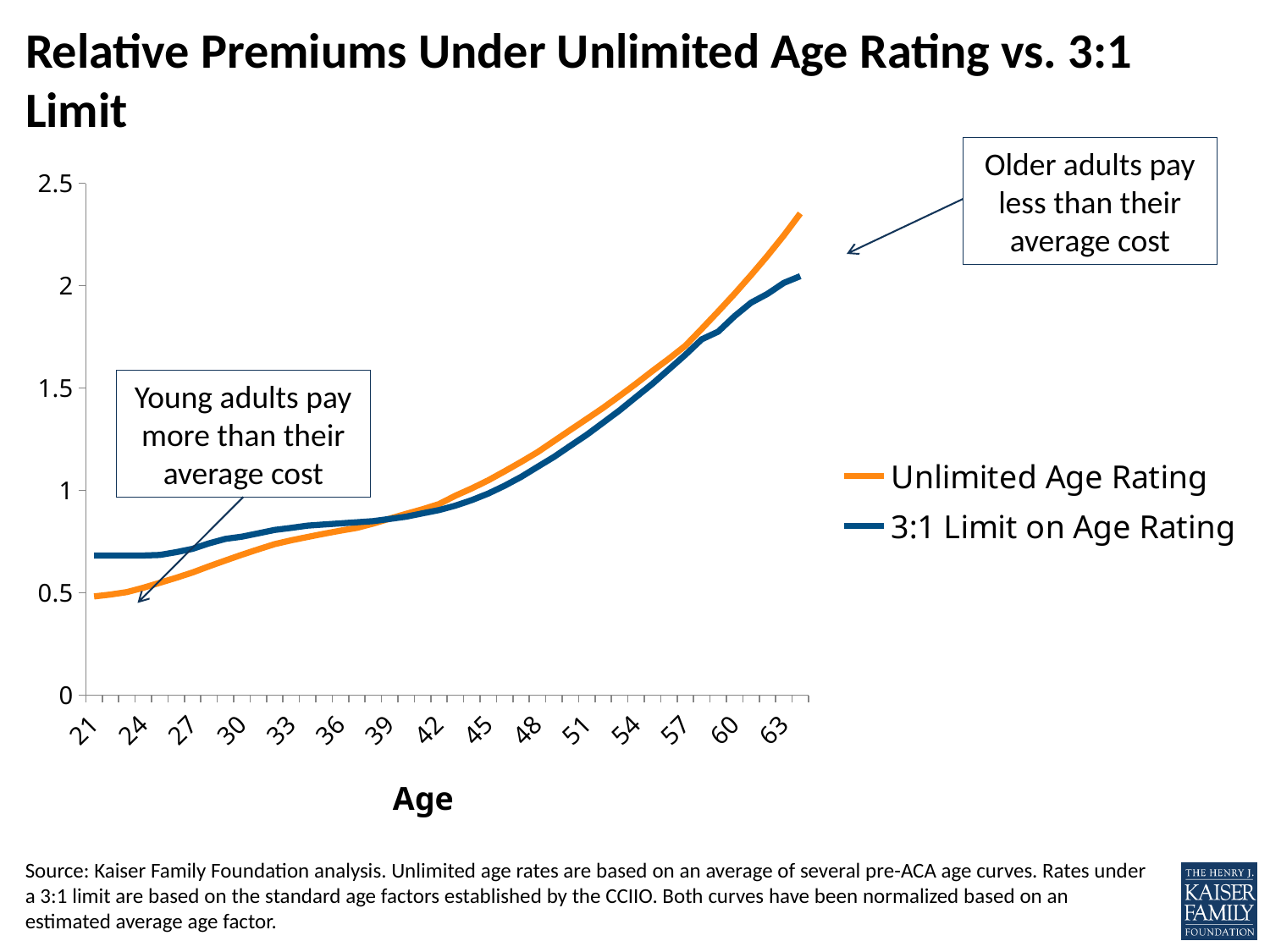
At age 30, which series has the higher value, Unlimited Age Rating or 3:1 Limit on Age Rating? 3:1 Limit on Age Rating Is the value for Unlimited Age Rating at age 63 greater or less than 2? greater How many series does the legend list? 2 What is the title of the chart? Relative Premiums Under Unlimited Age Rating vs. 3:1 Limit At age 63, which series has the higher value, Unlimited Age Rating or 3:1 Limit on Age Rating? Unlimited Age Rating Do the values for Unlimited Age Rating rise or fall as age increases? Rise Is the value for 3:1 Limit on Age Rating at age 21 greater or less than 0.5? greater At age 21, which series has the higher value, Unlimited Age Rating or 3:1 Limit on Age Rating? 3:1 Limit on Age Rating What kind of chart is shown on the slide? Line chart Is the value for Unlimited Age Rating at age 21 greater or less than 1? less What is the label on the x axis? Age Do the values for 3:1 Limit on Age Rating rise or fall as age increases? Rise